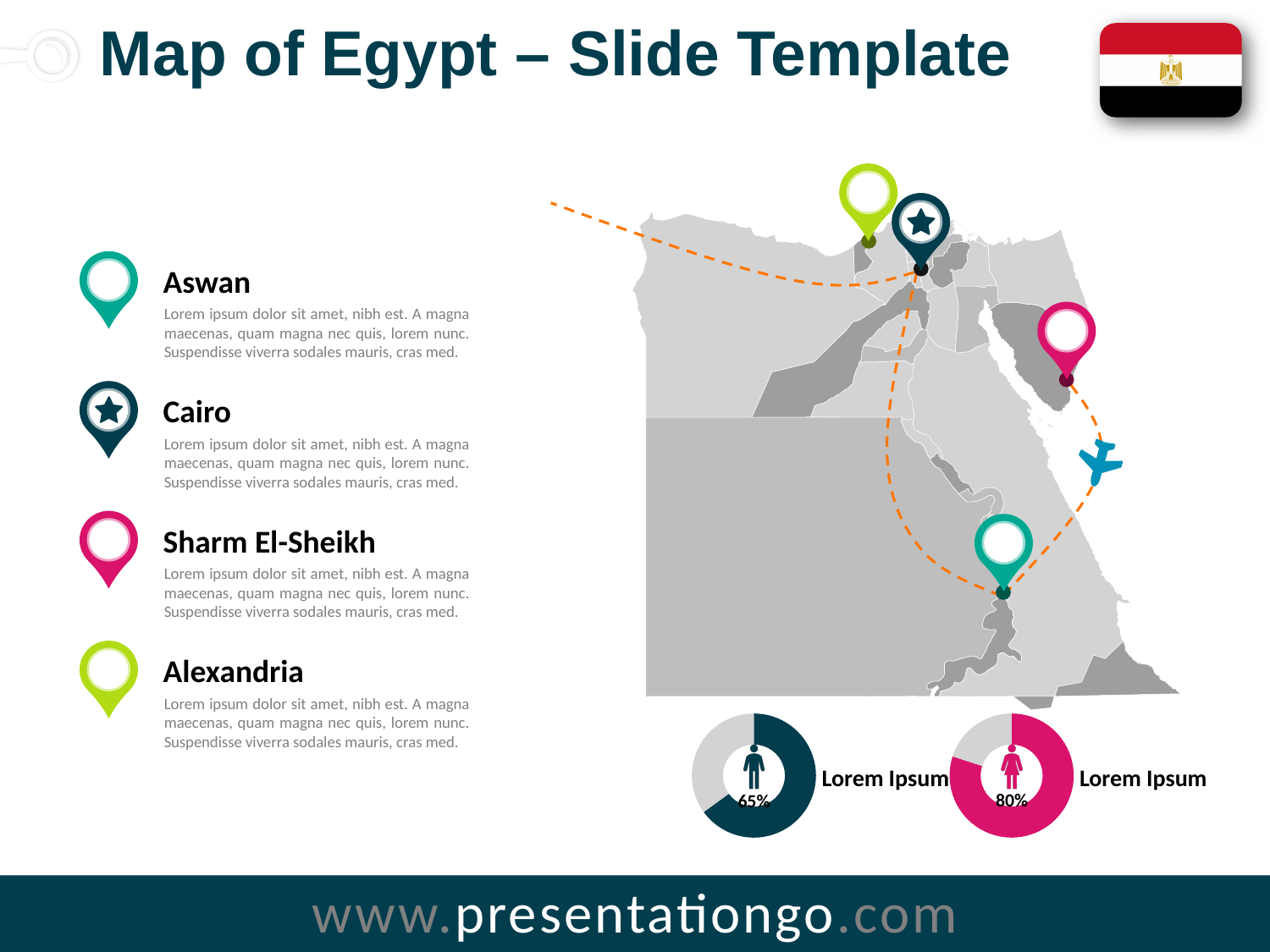
What value is shown in the left donut chart with the male figure icon? 65% What is the difference between the percentage in the right donut chart and the percentage in the left donut chart? 15% What value is shown in the right donut chart with the female figure icon? 80% Which donut chart has the smaller filled share, the one with the male icon or the one with the female icon? the one with the male icon How many donut charts are shown at the bottom of the slide? 2 What label text appears next to each of the two donut charts? Lorem Ipsum Is the value in the left donut chart greater or less than 50%? greater Is the value in the right donut chart greater or less than 90%? less Which of the two donut charts at the bottom of the slide shows the higher percentage, the left one or the right one? the right one What kind of chart is used to display the 65% and 80% values at the bottom of the slide? donut chart What colour is the filled portion of the left donut chart showing 65%? dark teal